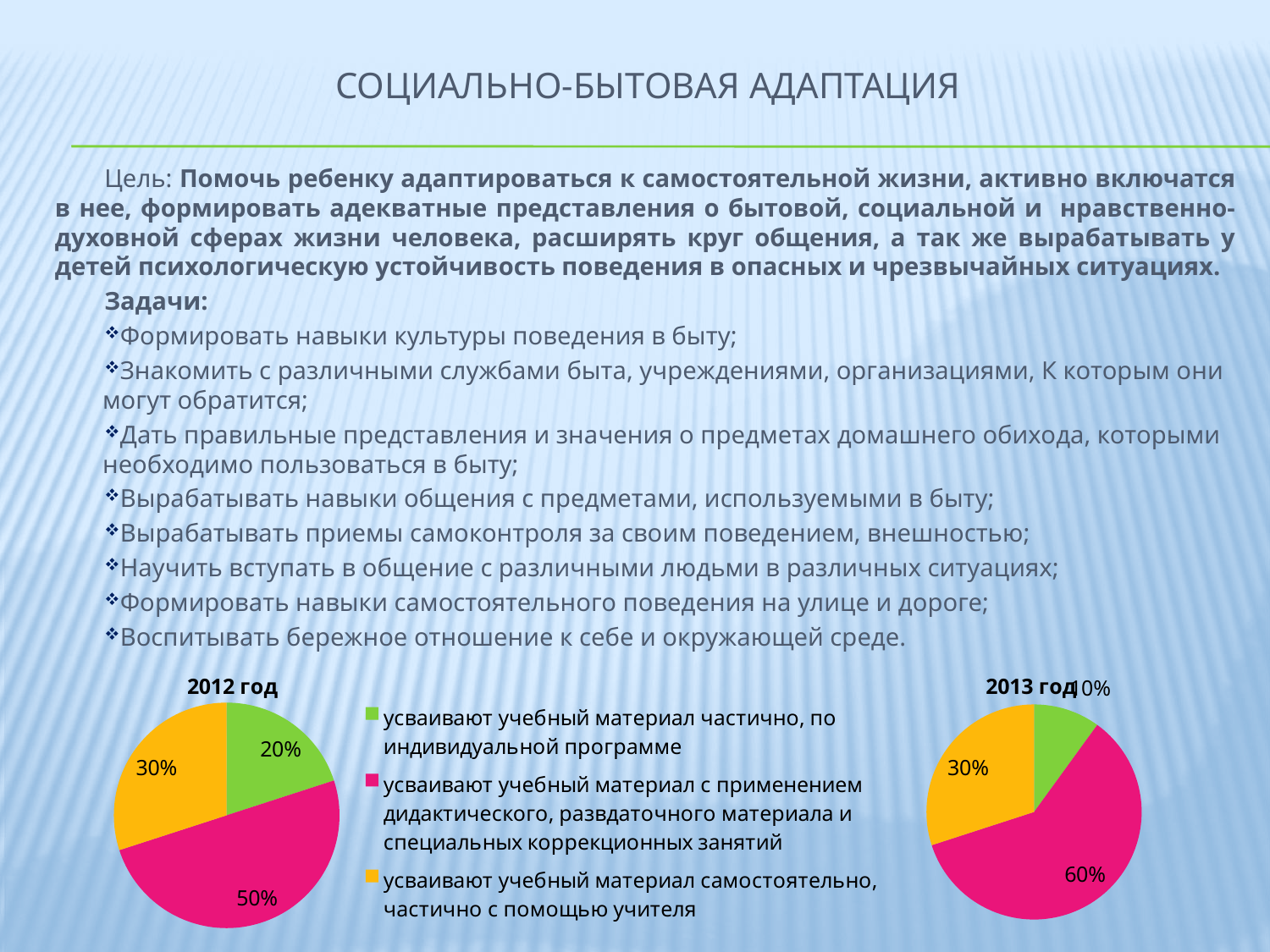
Какая доля больше: категория «усваивают учебный материал частично, по индивидуальной программе» на диаграмме «2012 год» или на диаграмме «2013 год»? 2012 год На диаграмме «2013 год» какая категория имеет наибольшую долю? усваивают учебный материал с применением дидактического, раздаточного материала и специальных коррекционных занятий Каким цветом на диаграммах обозначена категория «усваивают учебный материал самостоятельно, частично с помощью учителя»? жёлтым На диаграмме «2012 год» какая доля приходится на категорию «усваивают учебный материал самостоятельно, частично с помощью учителя»? 30% Сколько элементов перечислено в легенде диаграмм? 3 На диаграмме «2013 год» на сколько процентных пунктов доля категории «с применением дидактического, раздаточного материала и специальных коррекционных занятий» больше доли категории «самостоятельно, частично с помощью учителя»? 30 Какого типа диаграмма «2013 год»? круговая диаграмма На диаграмме «2012 год» какая категория имеет наименьшую долю? усваивают учебный материал частично, по индивидуальной программе На диаграмме «2013 год» какая доля приходится на категорию «усваивают учебный материал частично, по индивидуальной программе»? 10% Сколько категорий показано на диаграмме «2012 год»? 3 На диаграмме «2012 год» какая доля приходится на категорию «усваивают учебный материал с применением дидактического, раздаточного материала и специальных коррекционных занятий»? 50% На диаграмме «2012 год» на сколько процентных пунктов доля категории «с применением дидактического, раздаточного материала и специальных коррекционных занятий» больше доли категории «частично, по индивидуальной программе»? 30